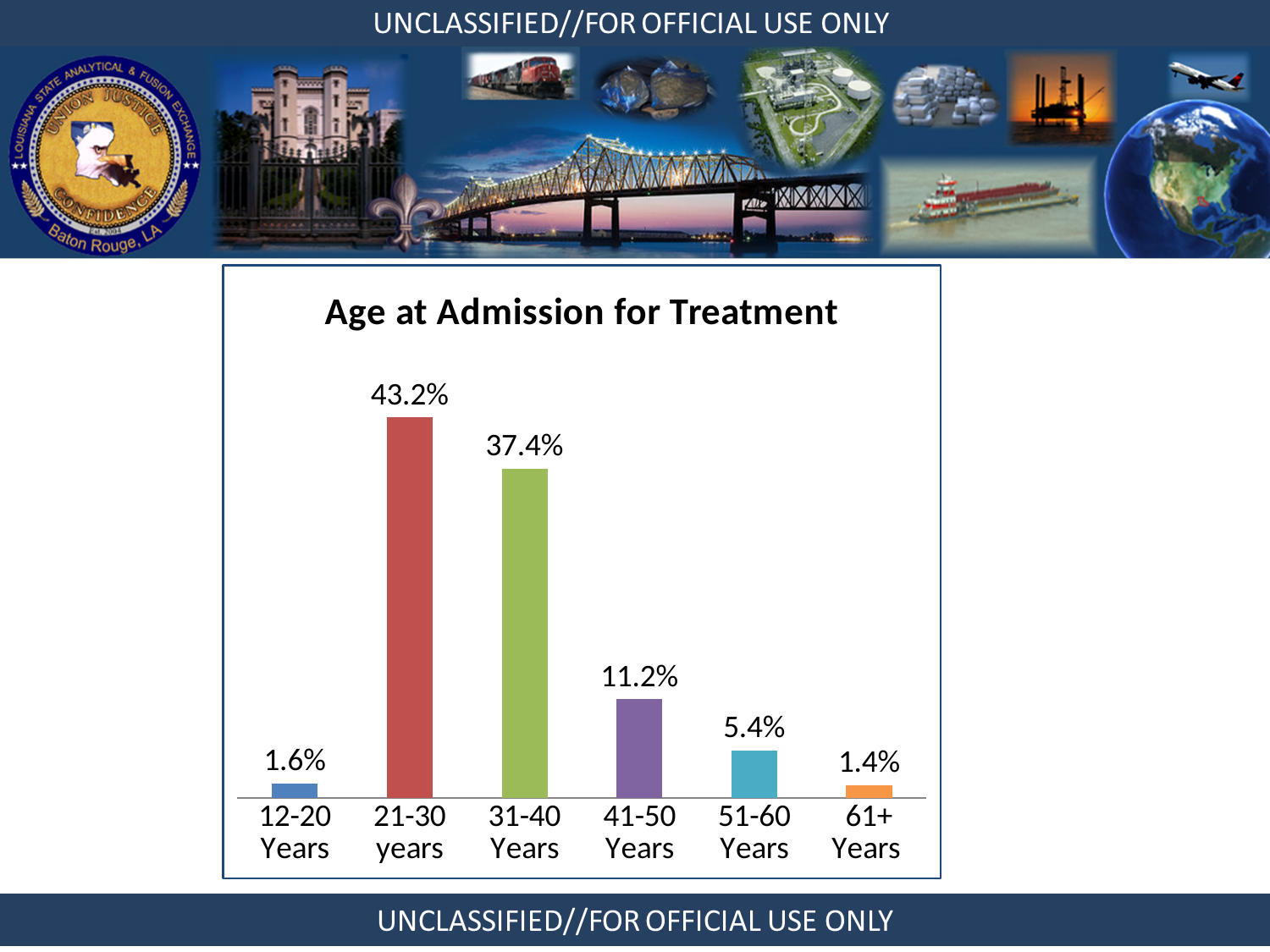
How many age groups are shown in the chart? 6 Which is larger, the value for 12-20 Years or the value for 51-60 Years? 51-60 Years Which age group has the lowest value? 61+ Years What is the value for the 61+ Years age group? 1.4% From 21-30 years onward, do the values rise or fall as age increases? Fall What is the difference between the values for 41-50 Years and 51-60 Years? 5.8% What is the value for the 21-30 years age group? 43.2% What is the title of the chart? Age at Admission for Treatment What is the difference between the values for 21-30 years and 31-40 Years? 5.8% Which age group has the highest value? 21-30 years What is the value for the 41-50 Years age group? 11.2% What kind of chart is shown on the slide? Bar chart